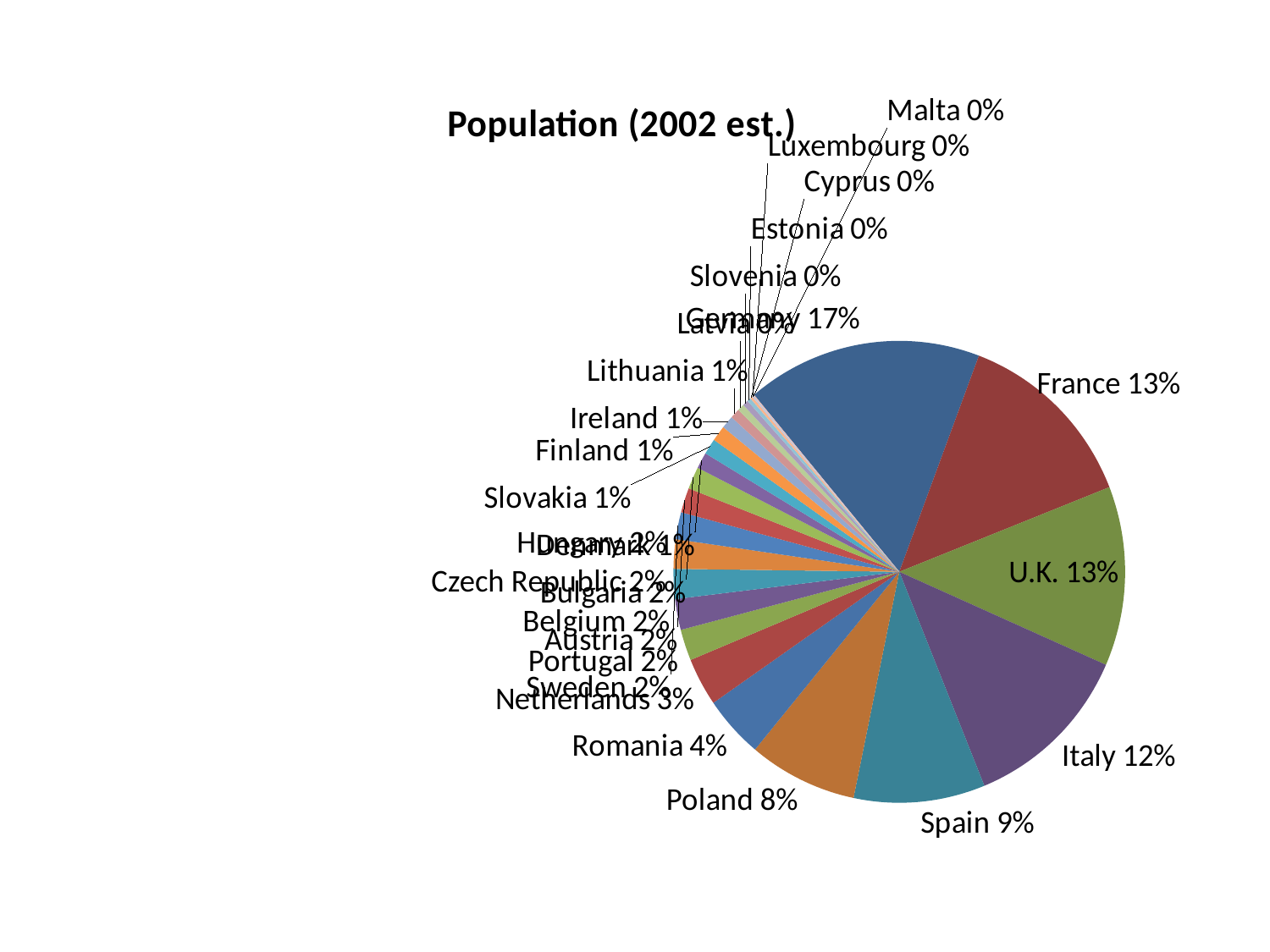
What type of chart is shown on the slide? pie chart What is the title of the chart? Population (2002 est.) Which country has the largest slice of the pie? Germany What share of the pie does Spain hold? 9% What share of the pie does the Netherlands hold? 3% Which has the larger share, Spain or Poland? Spain What share of the pie does Romania hold? 4% What is the difference in percentage points between Germany's share and Italy's share? 5